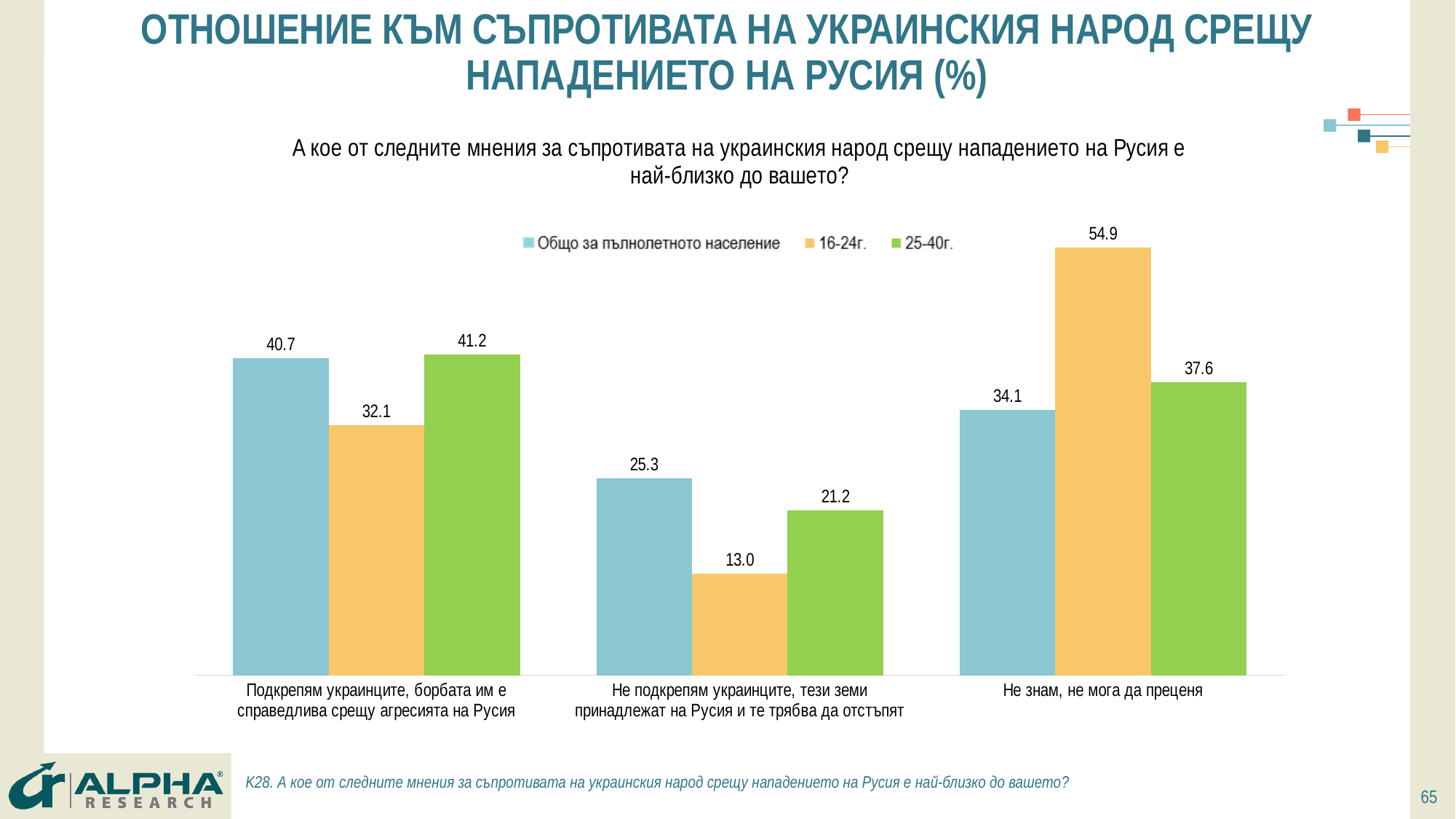
What is the value for the 25-40г. series in the 'Не подкрепям украинците, тези земи принадлежат на Русия и те трябва да отстъпят' category? 21.2 What is the value for the 16-24г. series in the 'Не знам, не мога да преценя' category? 54.9 How many categories are shown on the x axis? 3 Which series has the lowest value in the 'Не подкрепям украинците, тези земи принадлежат на Русия и те трябва да отстъпят' category? 16-24г. Which colour represents the 16-24г. series in the legend? Orange How many series does the legend list? 3 What is the difference between the 16-24г. value and the 25-40г. value in the 'Не знам, не мога да преценя' category? 17.3 What kind of chart is shown on the slide? Bar chart Which series has the highest value in the 'Не знам, не мога да преценя' category? 16-24г. What is the value for 'Общо за пълнолетното население' in the 'Подкрепям украинците, борбата им е справедлива срещу агресията на Русия' category? 40.7 What is the difference between the 'Общо за пълнолетното население' value and the 16-24г. value in the 'Подкрепям украинците, борбата им е справедлива срещу агресията на Русия' category? 8.6 Which is larger: the 25-40г. value for 'Подкрепям украинците, борбата им е справедлива срещу агресията на Русия' or the 25-40г. value for 'Не знам, не мога да преценя'? Подкрепям украинците, борбата им е справедлива срещу агресията на Русия